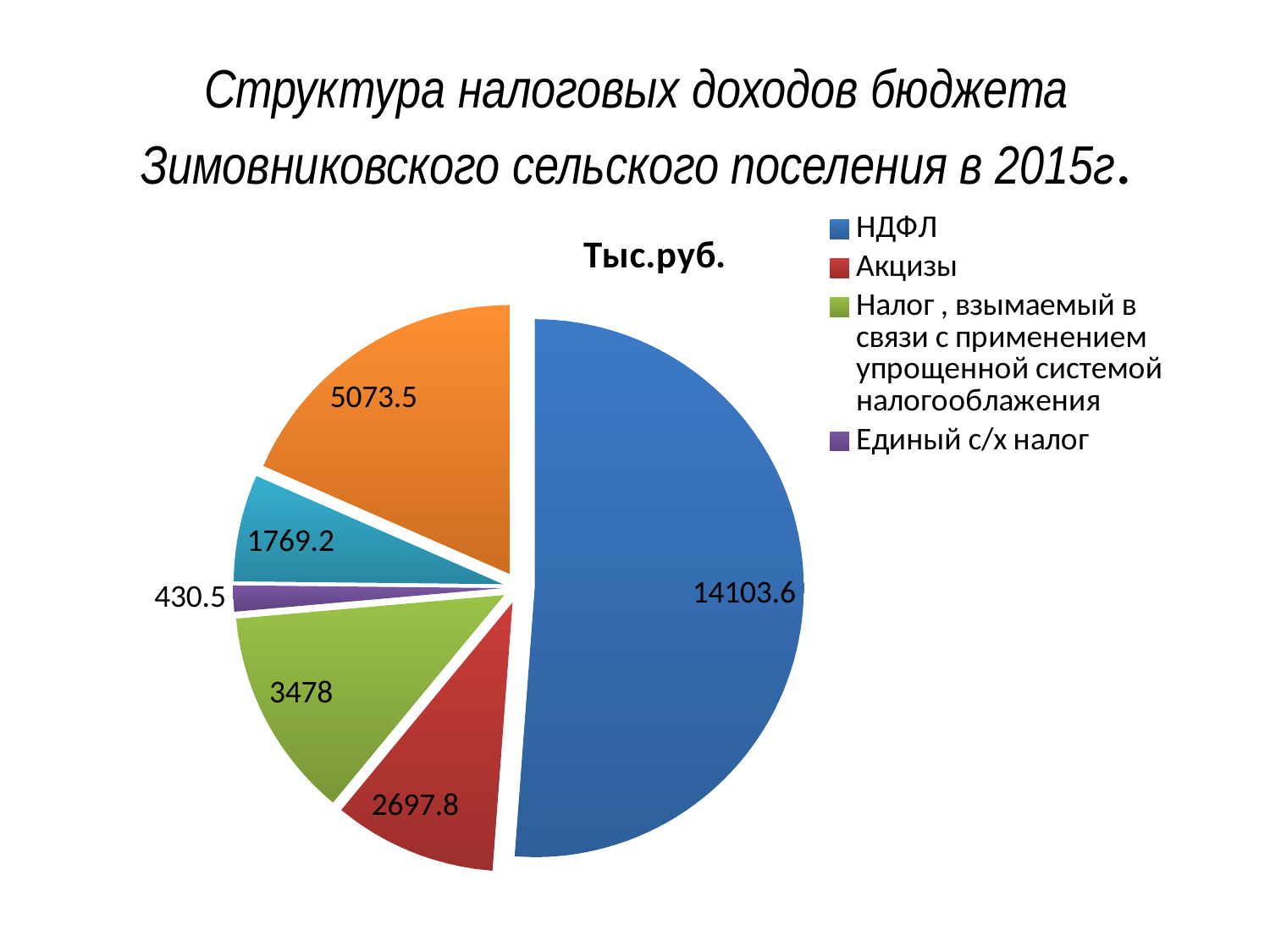
What kind of chart is shown on the slide? Pie chart Which legend category has the largest slice of the pie? НДФЛ What is the value for Единый с/х налог in the pie chart? 430.5 What is the value for Акцизы in the pie chart? 2697.8 Which legend category has the smallest slice of the pie? Единый с/х налог Which is larger: the value for Акцизы or the value for Налог, взымаемый в связи с применением упрощенной системой налогооблажения? Налог, взымаемый в связи с применением упрощенной системой налогооблажения How many entries does the legend list? 4 How many slices does the pie chart have? 6 What is the value for Налог, взымаемый в связи с применением упрощенной системой налогооблажения? 3478 What is the difference between the values for НДФЛ and Акцизы? 11405.8 What is the title shown above the pie chart? Тыс.руб. What is the value for НДФЛ in the pie chart? 14103.6